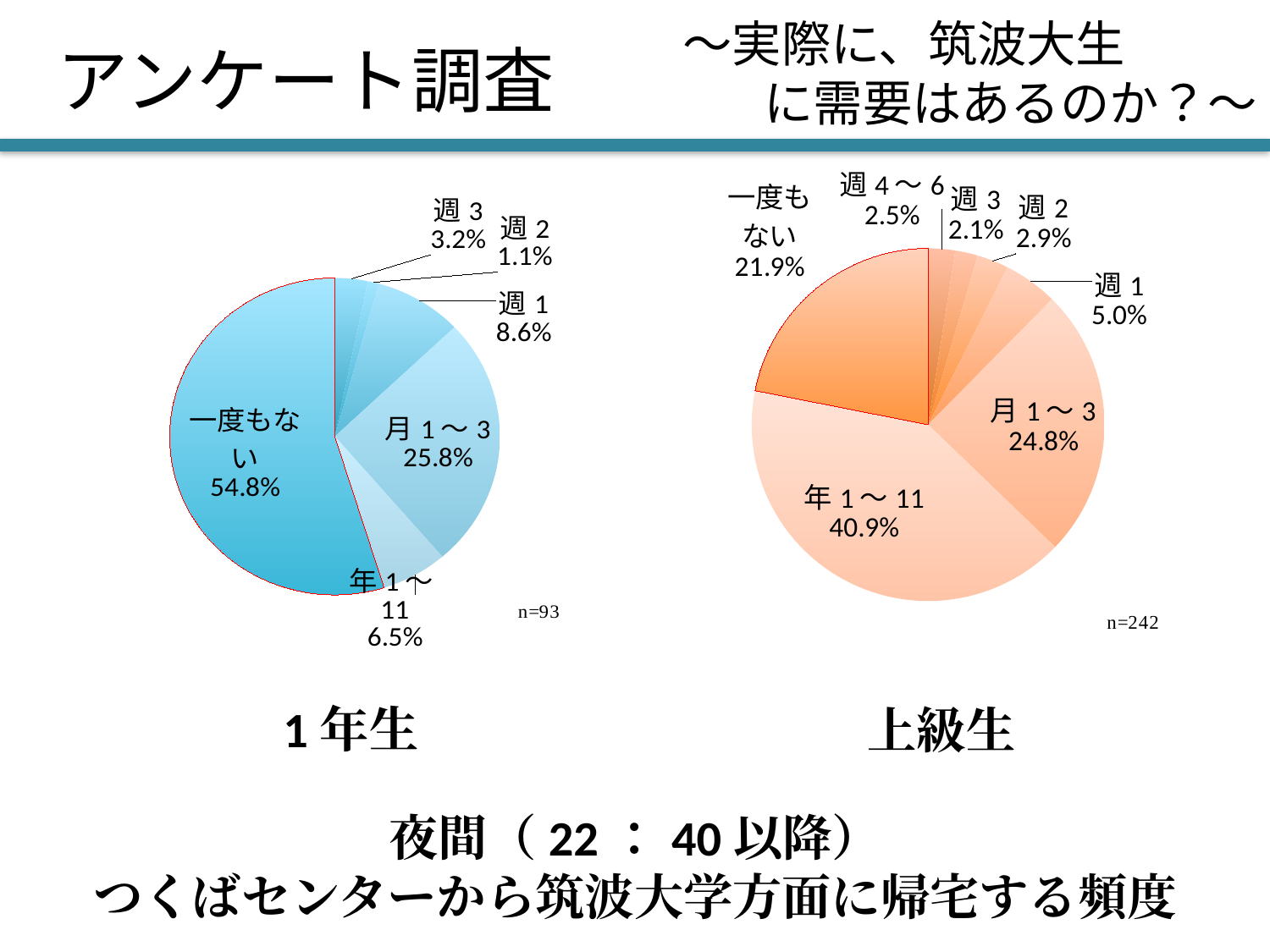
In the 1年生 pie chart on the left, which category has the smallest share? 週2 In the 上級生 pie chart on the right, which category has the smallest share? 週3 In the 1年生 pie chart on the left, what is the difference between the shares for 週1 and 年1〜11? 2.1% In the 上級生 pie chart on the right, how many slices are there? 7 In the 上級生 pie chart on the right, which category has the largest share? 年1〜11 In the 1年生 pie chart on the left, what share is labelled for 月1〜3? 25.8% What sample size (n) is shown for the 上級生 pie chart on the right? n=242 Which is larger: the share for 一度もない in the 1年生 chart on the left or in the 上級生 chart on the right? 1年生 chart (54.8%) In the 1年生 pie chart on the left, what share is labelled for 一度もない? 54.8% What kind of chart is used for the 1年生 (first-year students) data on the left? pie chart In the 1年生 pie chart on the left, how many slices are there? 6 In the 上級生 pie chart on the right, what share is labelled for 年1〜11? 40.9%